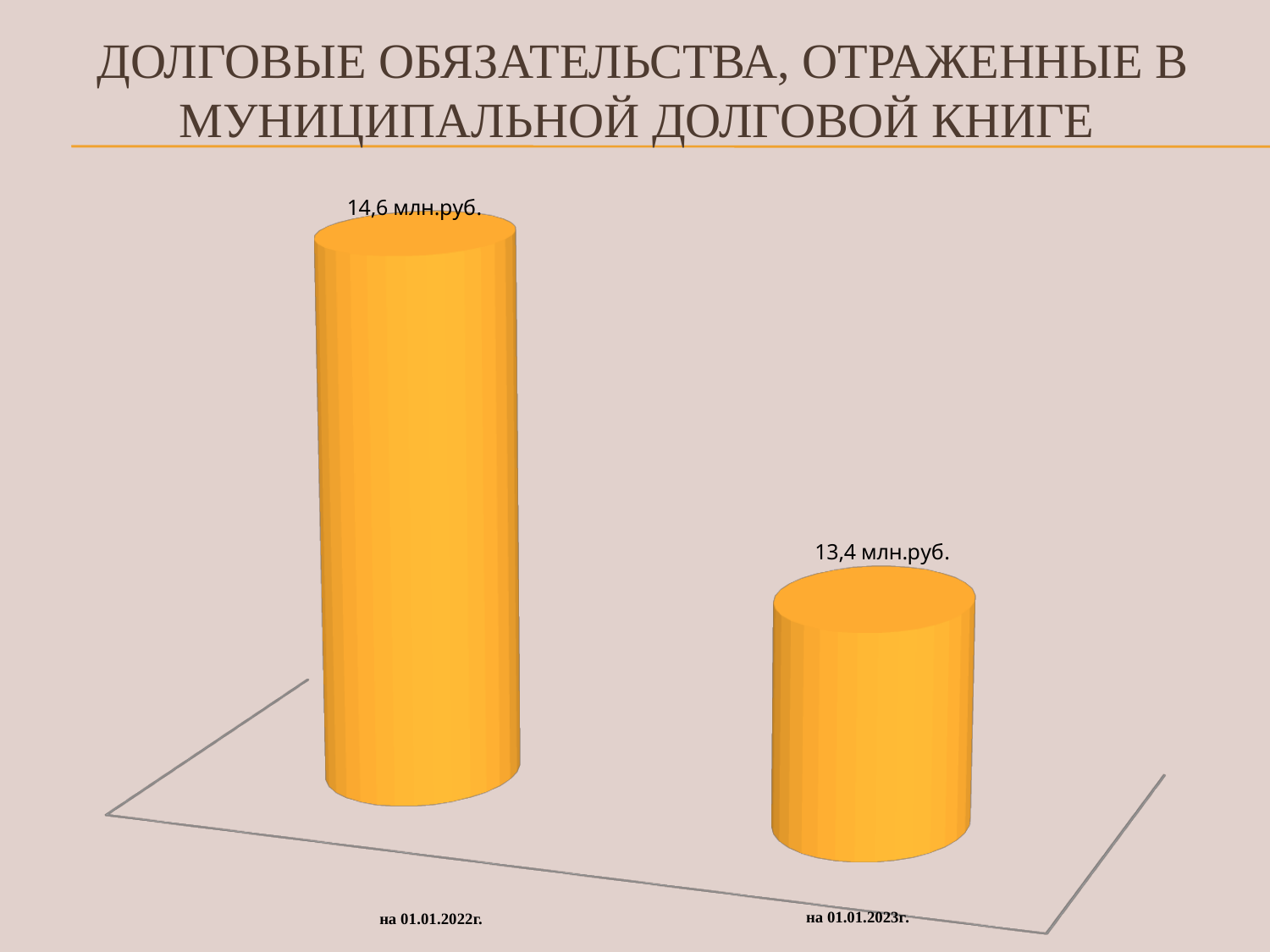
Which category has the lowest value? на 01.01.2023г. Do the values rise or fall from на 01.01.2022г. to на 01.01.2023г.? fall What is the value for на 01.01.2023г.? 13,4 млн.руб. How many categories are shown in the chart? 2 What is the value for на 01.01.2022г.? 14,6 млн.руб. What is the difference between the values for на 01.01.2022г. and на 01.01.2023г.? 1,2 млн.руб. Which is larger, the value for на 01.01.2022г. or the value for на 01.01.2023г.? на 01.01.2022г. Which category has the highest value? на 01.01.2022г. What is the title of the slide? ДОЛГОВЫЕ ОБЯЗАТЕЛЬСТВА, ОТРАЖЕННЫЕ В МУНИЦИПАЛЬНОЙ ДОЛГОВОЙ КНИГЕ What colour are the bars in the chart? orange What kind of chart is shown on the slide? bar chart